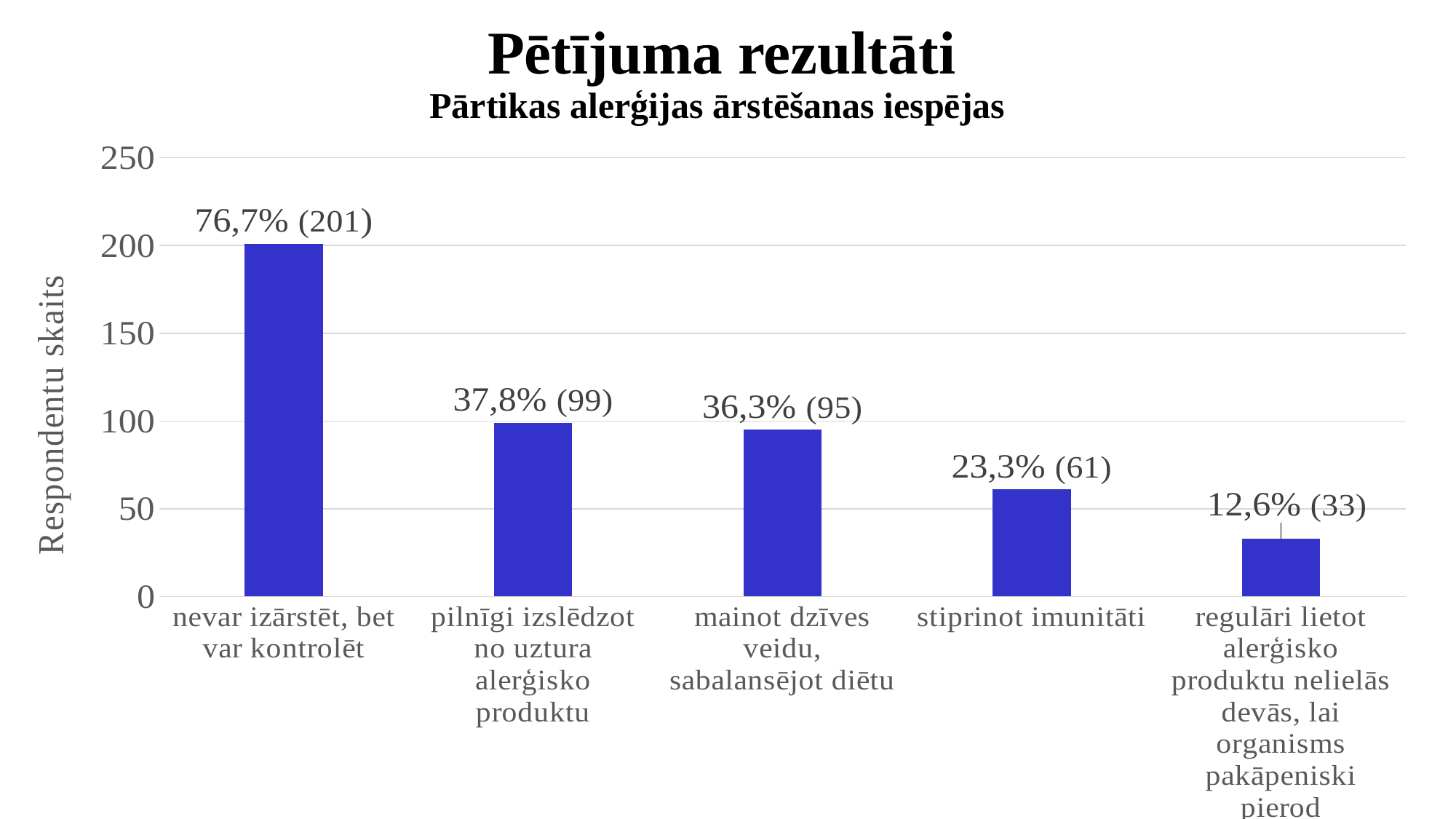
How many categories are shown on the chart? 5 What is the difference in respondent count between "nevar izārstēt, bet var kontrolēt" and "pilnīgi izslēdzot no uztura alerģisko produktu"? 102 What kind of chart is shown on the slide? bar chart How many respondents chose "stiprinot imunitāti"? 61 Which has more respondents: "stiprinot imunitāti" or "mainot dzīves veidu, sabalansējot diētu"? mainot dzīves veidu, sabalansējot diētu Is the value for "stiprinot imunitāti" greater or less than 100? less Which category has the highest number of respondents? nevar izārstēt, bet var kontrolēt What is the label of the vertical axis? Respondentu skaits Which category has the lowest number of respondents? regulāri lietot alerģisko produktu nelielās devās, lai organisms pakāpeniski pierod What is the data label shown for the bar "nevar izārstēt, bet var kontrolēt"? 76,7% (201) How many respondents chose "pilnīgi izslēdzot no uztura alerģisko produktu"? 99 What percentage is shown for "mainot dzīves veidu, sabalansējot diētu"? 36,3%